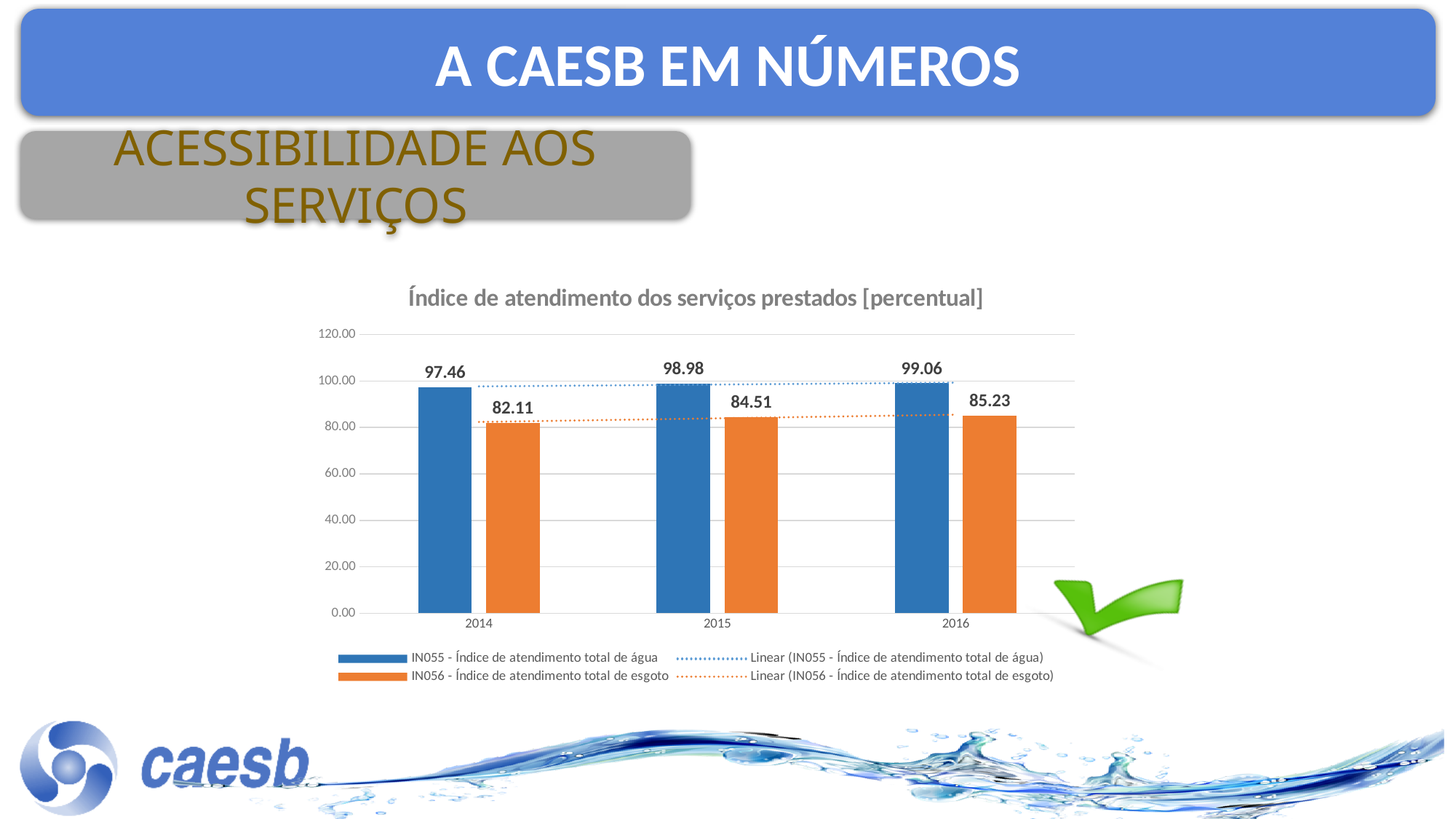
Does IN056 - Índice de atendimento total de esgoto rise or fall from 2014 to 2016? Rise Which is larger in 2015: IN055 - Índice de atendimento total de água or IN056 - Índice de atendimento total de esgoto? IN055 - Índice de atendimento total de água What is the value of IN055 - Índice de atendimento total de água for 2014? 97.46 What is the difference between the IN056 values for 2016 and 2014? 3.12 How many entries does the legend list? 4 What is the difference between IN055 and IN056 in 2014? 15.35 What is the value of IN056 - Índice de atendimento total de esgoto for 2016? 85.23 In which year is IN055 - Índice de atendimento total de água highest? 2016 What is the value of IN056 - Índice de atendimento total de esgoto for 2015? 84.51 How many years are shown on the x axis? 3 What kind of chart is shown? Bar chart In which year is IN056 - Índice de atendimento total de esgoto lowest? 2014